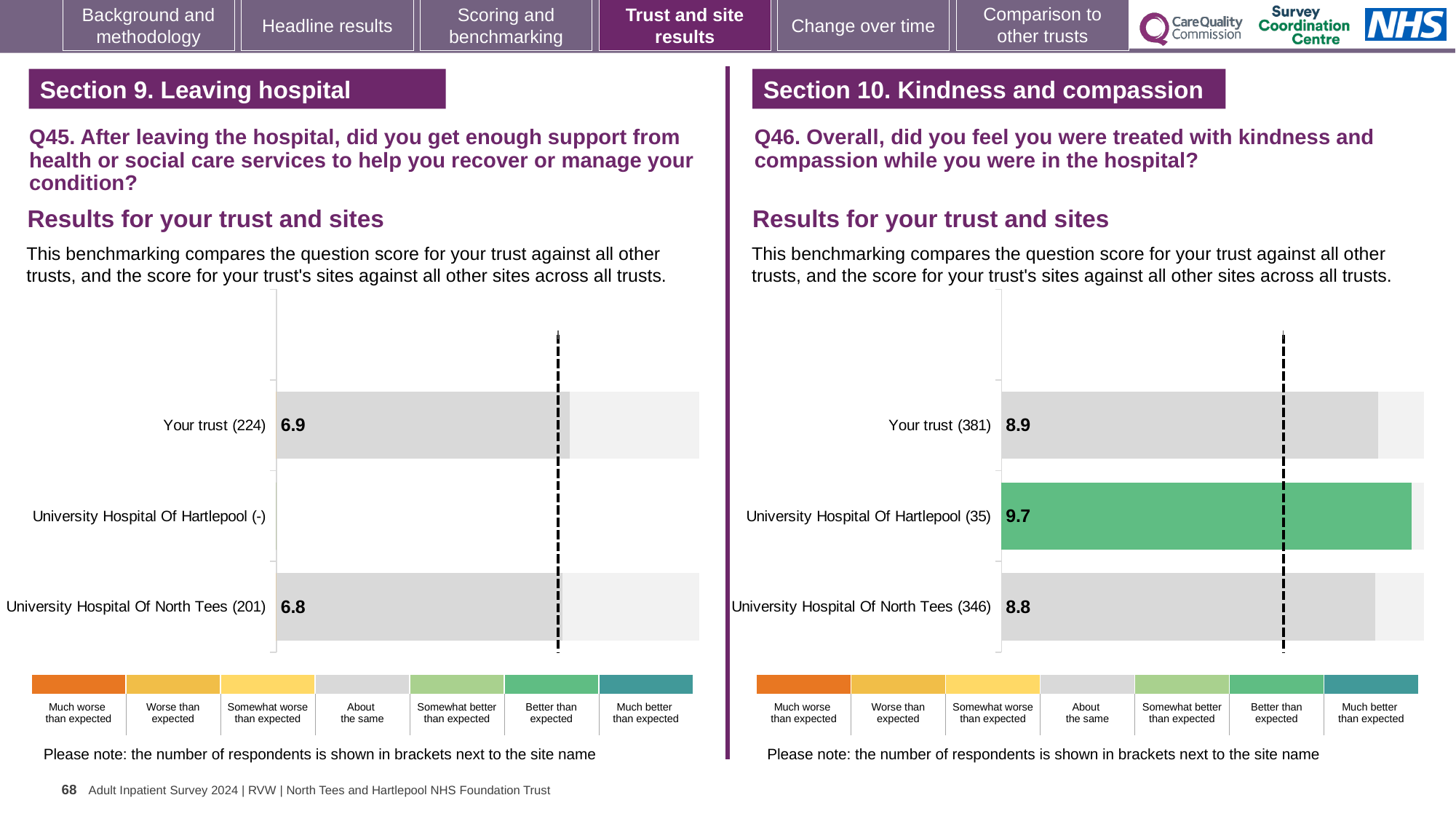
In the Q46 chart on the right, what is the score for University Hospital Of North Tees? 8.8 In the Q46 chart on the right, which site or trust has the highest score? University Hospital Of Hartlepool What type of chart is used in the Q45 chart on the left? Bar chart In the Q45 chart on the left, what is the score for Your trust? 6.9 In the Q45 chart on the left, what is the score for University Hospital Of North Tees? 6.8 In the Q46 chart on the right, which site or trust has the lowest score? University Hospital Of North Tees In the Q46 chart on the right, which benchmark category does the green bar for University Hospital Of Hartlepool correspond to in the legend? Better than expected In the Q46 chart on the right, how many respondents are shown for University Hospital Of Hartlepool? 35 In the Q45 chart on the left, what is the difference between the scores for Your trust and University Hospital Of North Tees? 0.1 In the Q46 chart on the right, what is the difference between the scores for University Hospital Of Hartlepool and Your trust? 0.8 In the Q46 chart on the right, what is the score for Your trust? 8.9 In the Q46 chart on the right, what is the score for University Hospital Of Hartlepool? 9.7